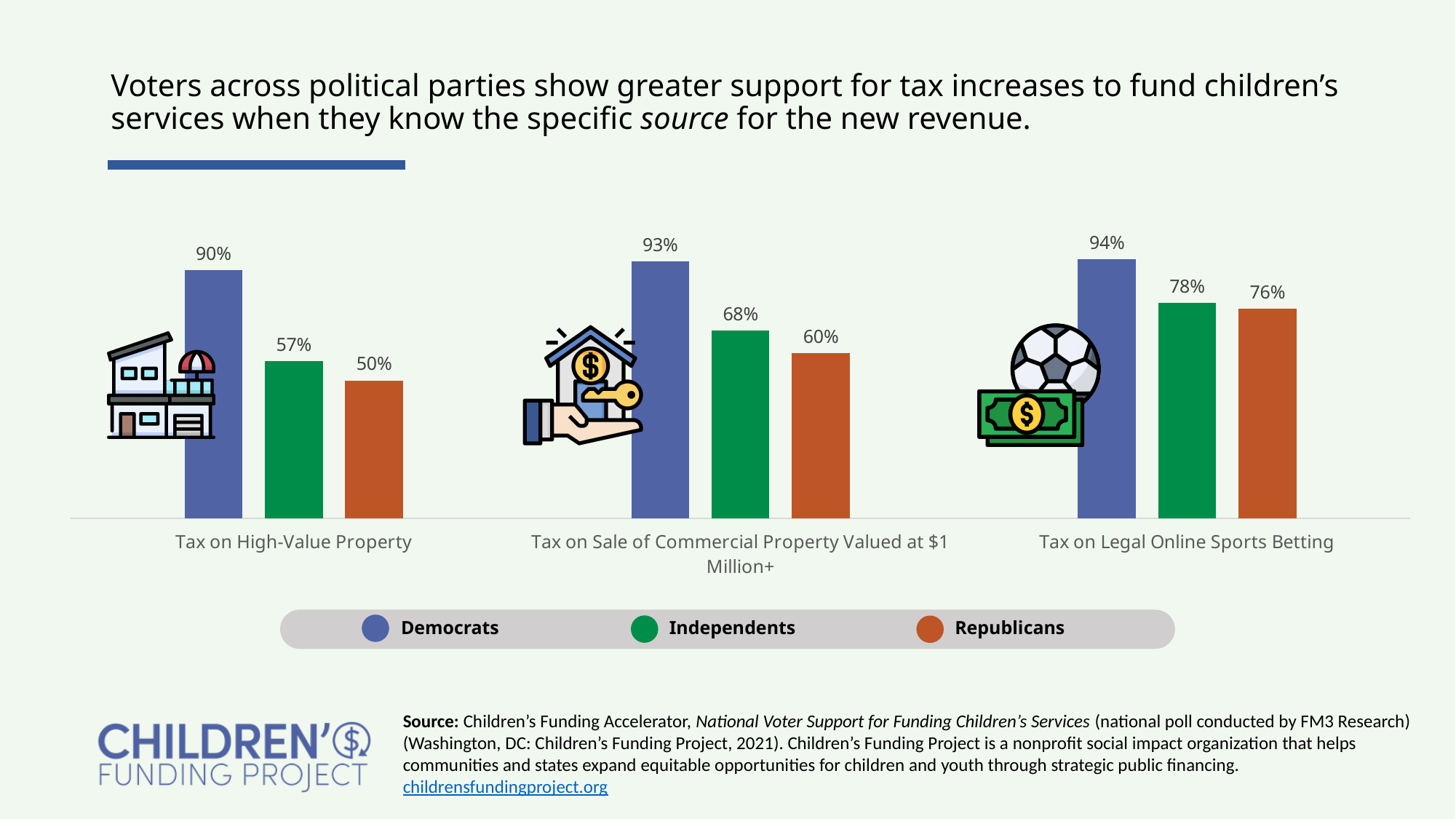
How many tax proposals are shown on the x axis? 3 What is the difference between Independent and Republican support for the Tax on Legal Online Sports Betting? 2 percentage points Which tax proposal has the highest support among Republicans? Tax on Legal Online Sports Betting How many series does the legend list? 3 Which is larger: Republican support for the Tax on Sale of Commercial Property Valued at $1 Million+ or Independent support for the Tax on High-Value Property? Republican support for the Tax on Sale of Commercial Property Valued at $1 Million+ What percentage of Independents support the Tax on Sale of Commercial Property Valued at $1 Million+? 68% What percentage of Republicans support the Tax on Legal Online Sports Betting? 76% Which colour represents Independents in the legend? Green Which tax proposal has the lowest support among Independents? Tax on High-Value Property What is the difference between Democrat and Republican support for the Tax on High-Value Property? 40 percentage points What kind of chart is shown on the slide? Bar chart What percentage of Democrats support the Tax on High-Value Property? 90%